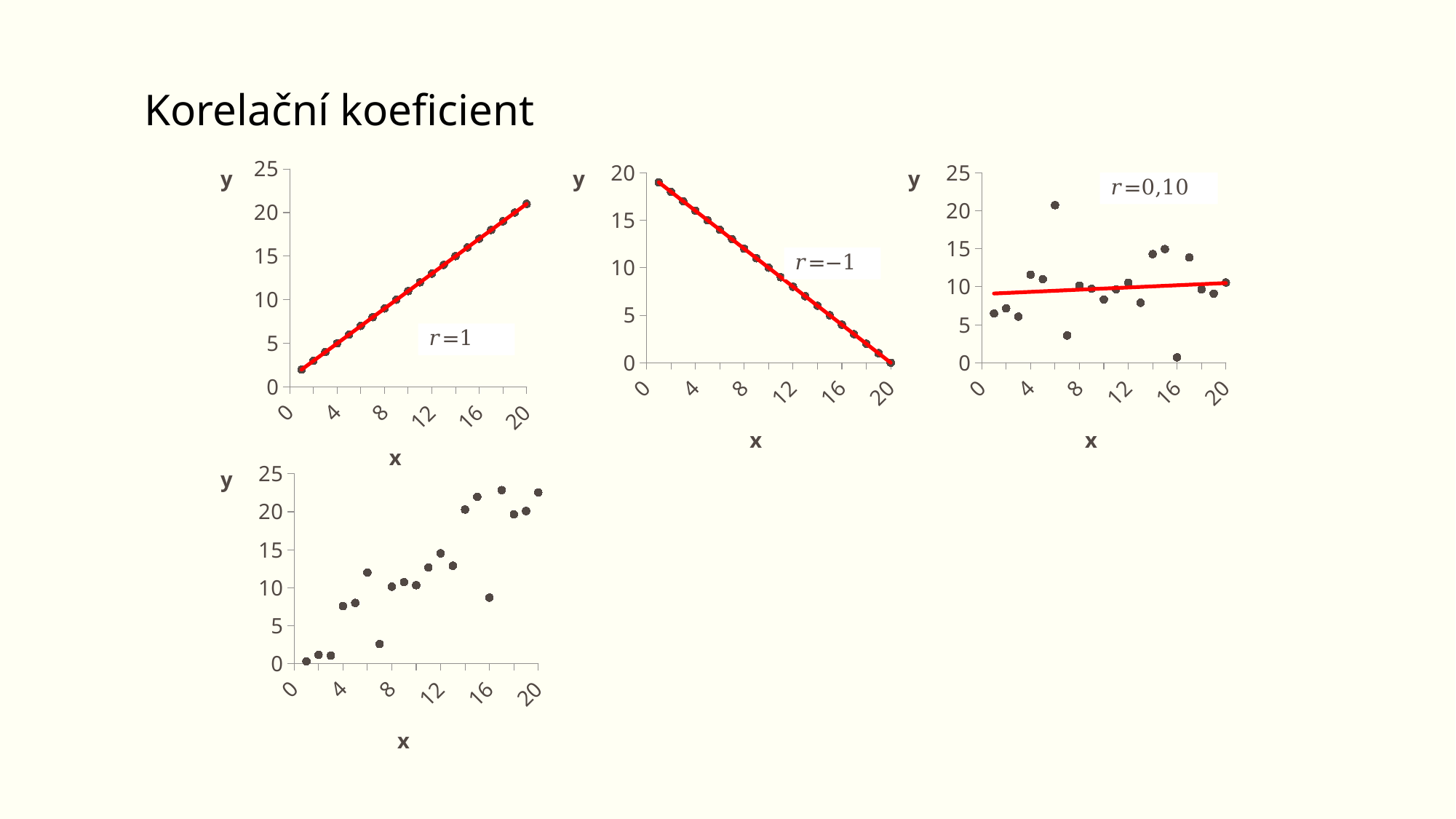
In the bottom-left chart, is the y value at x=16 greater or less than 10? less In the top-right chart labelled r=0,10, at which x value is the highest point? 6 In the top-middle chart labelled r=−1, is the y value at x=8 greater or less than 10? greater What kind of chart is the top-left chart labelled r=1? scatter chart In the bottom-left chart, do the y values generally rise or fall as x increases? rise In the top-middle chart labelled r=−1, do the y values rise or fall as x increases? fall In the top-left chart labelled r=1, do the y values rise or fall as x increases? rise What correlation coefficient is annotated on the top-right chart? r=0,10 In the top-left chart labelled r=1, is the y value at x=12 greater or less than 10? greater What colour is the fitted line drawn through the points in the top-middle chart labelled r=−1? red